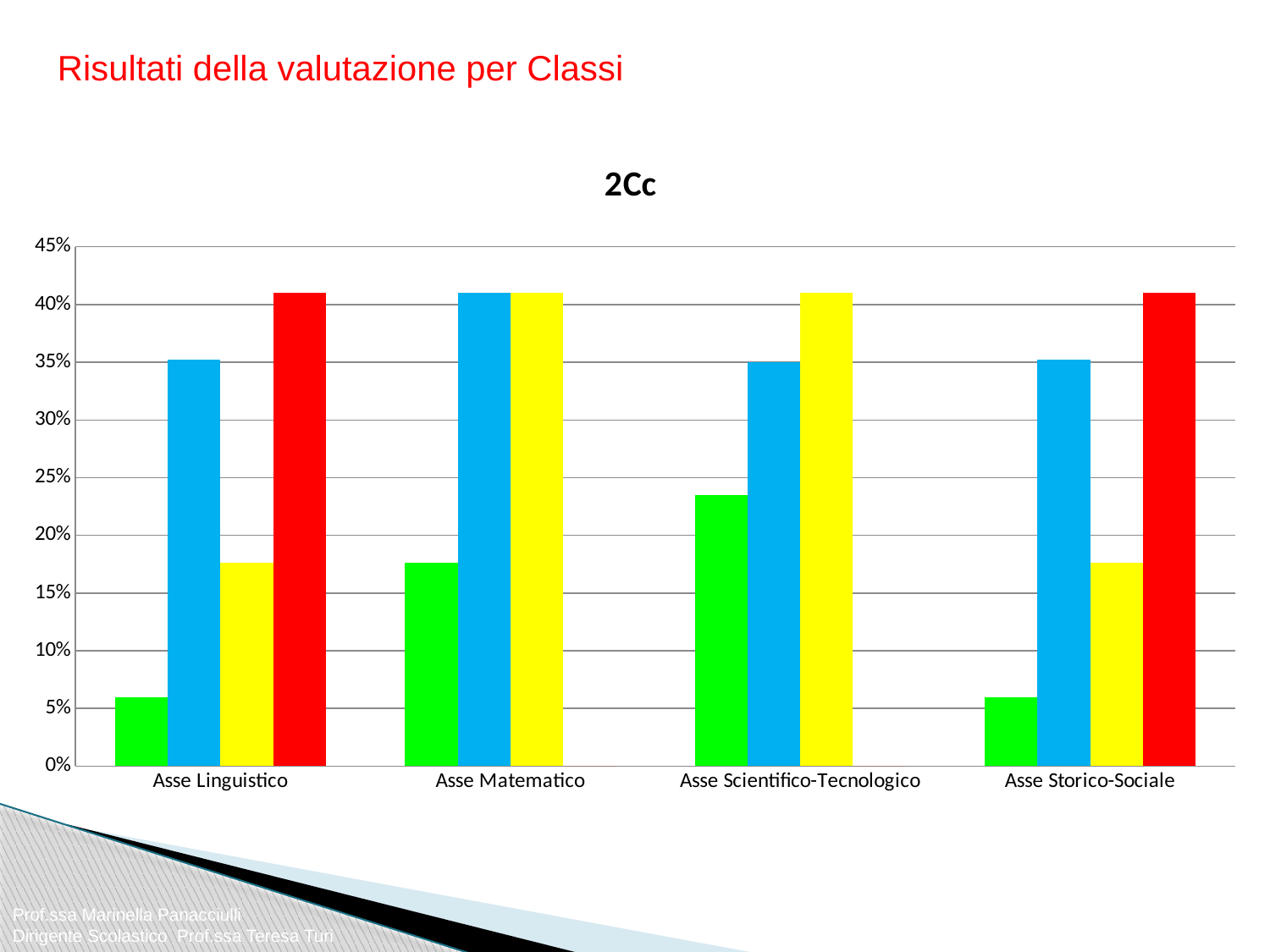
Is the value of the red bar for Asse Storico-Sociale greater or less than 40%? greater For Asse Linguistico, which is larger: the blue bar or the yellow bar? the blue bar Which bar is the tallest in the Asse Scientifico-Tecnologico category? the yellow bar What is the title of the chart? 2Cc Is the value of the green bar for Asse Linguistico greater or less than 10%? less How many categories are shown on the x axis of the chart? 4 What kind of chart is shown on the slide? bar chart Which category has the highest green bar? Asse Scientifico-Tecnologico Is the value of the green bar for Asse Scientifico-Tecnologico greater or less than 20%? greater Which category has the lowest green bar? Asse Linguistico and Asse Storico-Sociale